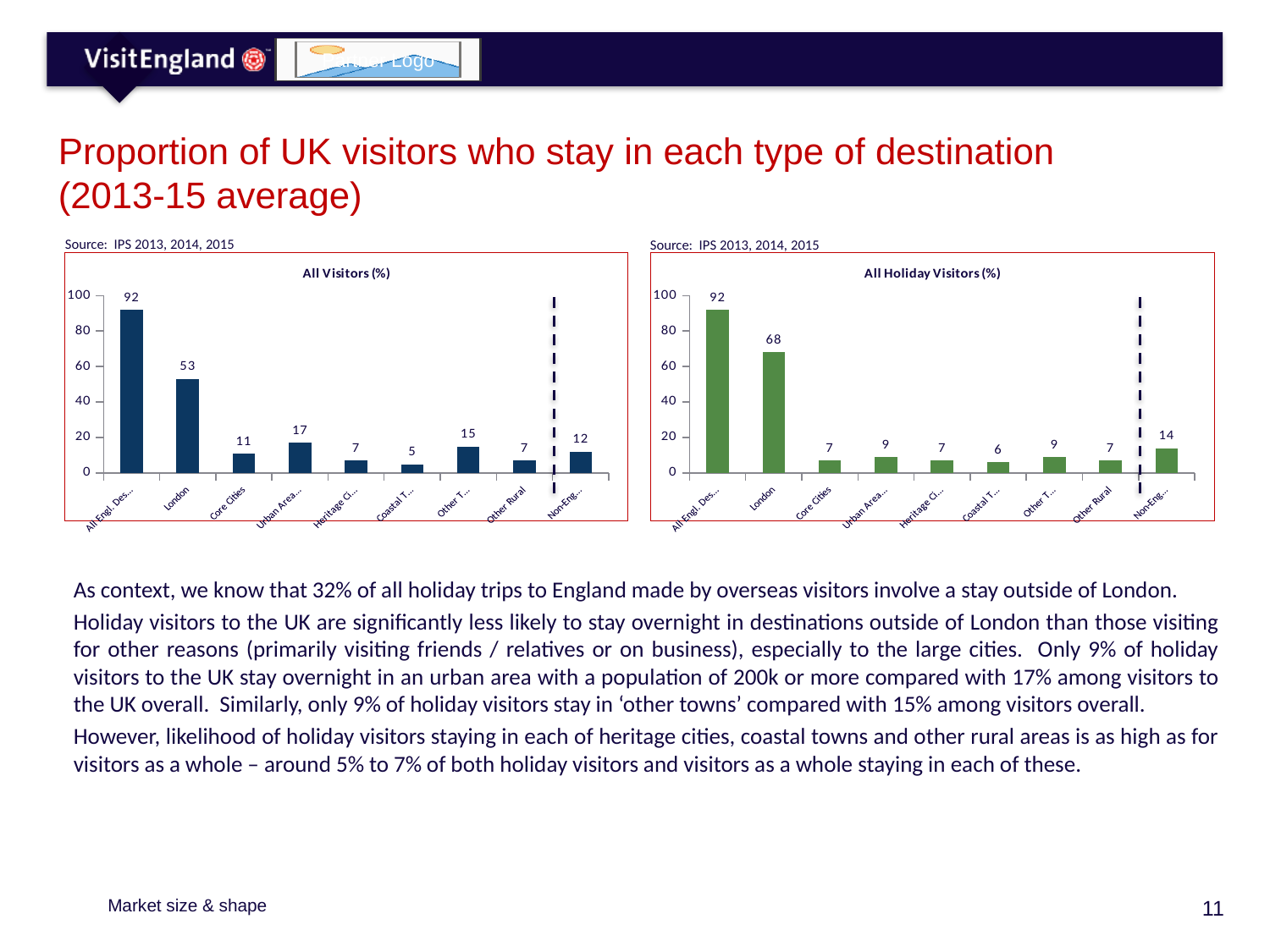
In the 'All Visitors (%)' chart, is the value for London greater or less than 40? greater What is the title of the chart on the right side of the slide? All Holiday Visitors (%) In the 'All Holiday Visitors (%)' chart, what is the value for Other Rural? 7 In the 'All Visitors (%)' chart, what is the value for Core Cities? 11 In the 'All Visitors (%)' chart, is the value for Core Cities greater or less than the value for London? less Which chart shows a higher value for London, 'All Visitors (%)' or 'All Holiday Visitors (%)'? All Holiday Visitors (%) In the 'All Visitors (%)' chart, what is the value for London? 53 In the 'All Holiday Visitors (%)' chart, which category has the lowest value? Coastal T... What kind of chart is the 'All Visitors (%)' chart? bar chart In the 'All Visitors (%)' chart, what is the difference between the values for London and Core Cities? 42 In the 'All Holiday Visitors (%)' chart, what is the value for London? 68 How many categories are shown on the x axis of the 'All Holiday Visitors (%)' chart? 9